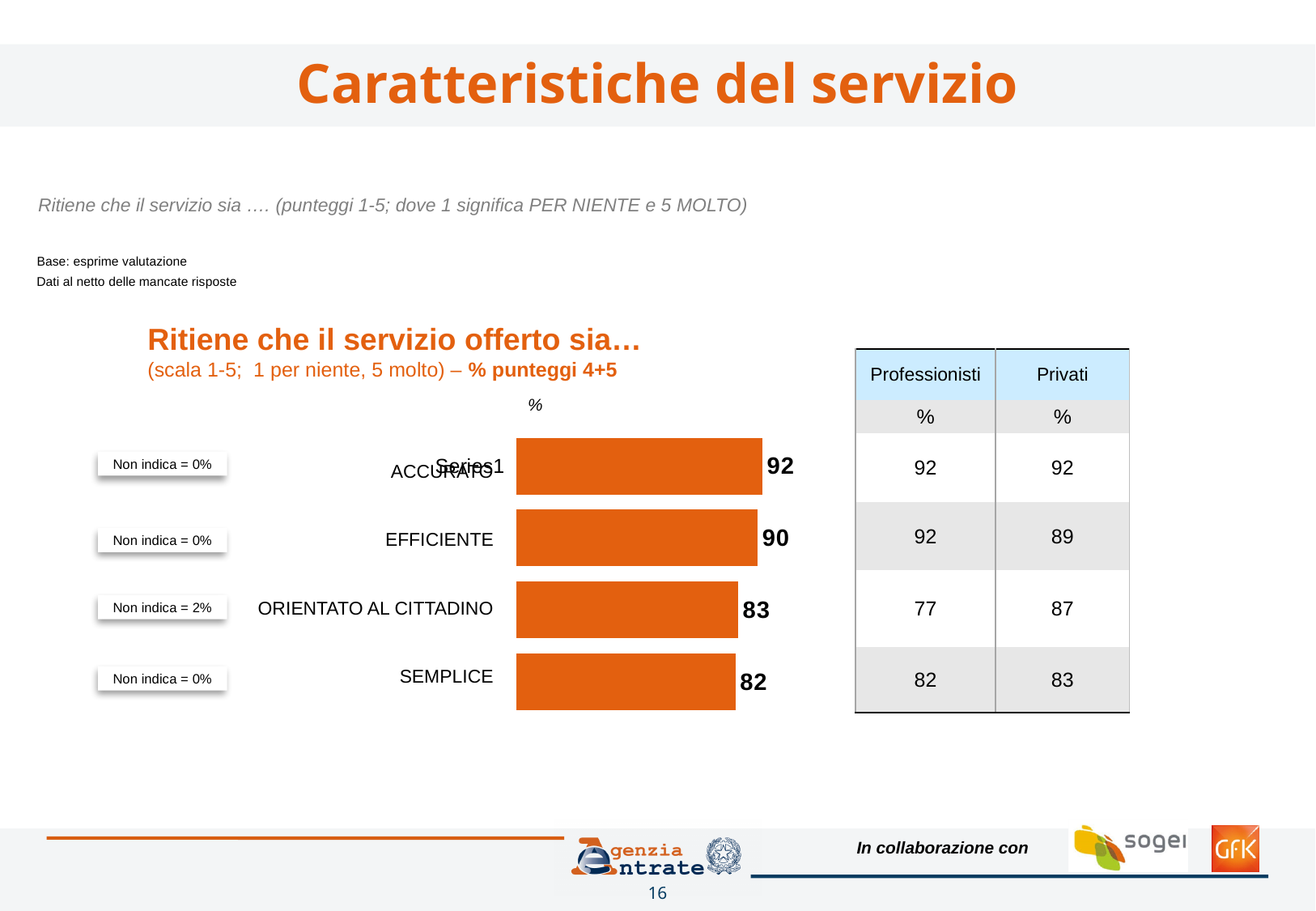
What is the value for EFFICIENTE in the bar chart? 90 What is the difference between the values for EFFICIENTE and ORIENTATO AL CITTADINO in the bar chart? 7 Which category has the highest value in the bar chart? ACCURATO Which has a larger value in the bar chart, EFFICIENTE or ORIENTATO AL CITTADINO? EFFICIENTE How many categories are shown in the bar chart? 4 What is the title of the chart on the slide? Ritiene che il servizio offerto sia… What is the value for SEMPLICE in the bar chart? 82 What is the value for ORIENTATO AL CITTADINO in the bar chart? 83 What is the difference between the values for ACCURATO and SEMPLICE in the bar chart? 10 What type of chart is shown on the slide? Bar chart What is the value for ACCURATO in the bar chart? 92 Which category has the lowest value in the bar chart? SEMPLICE